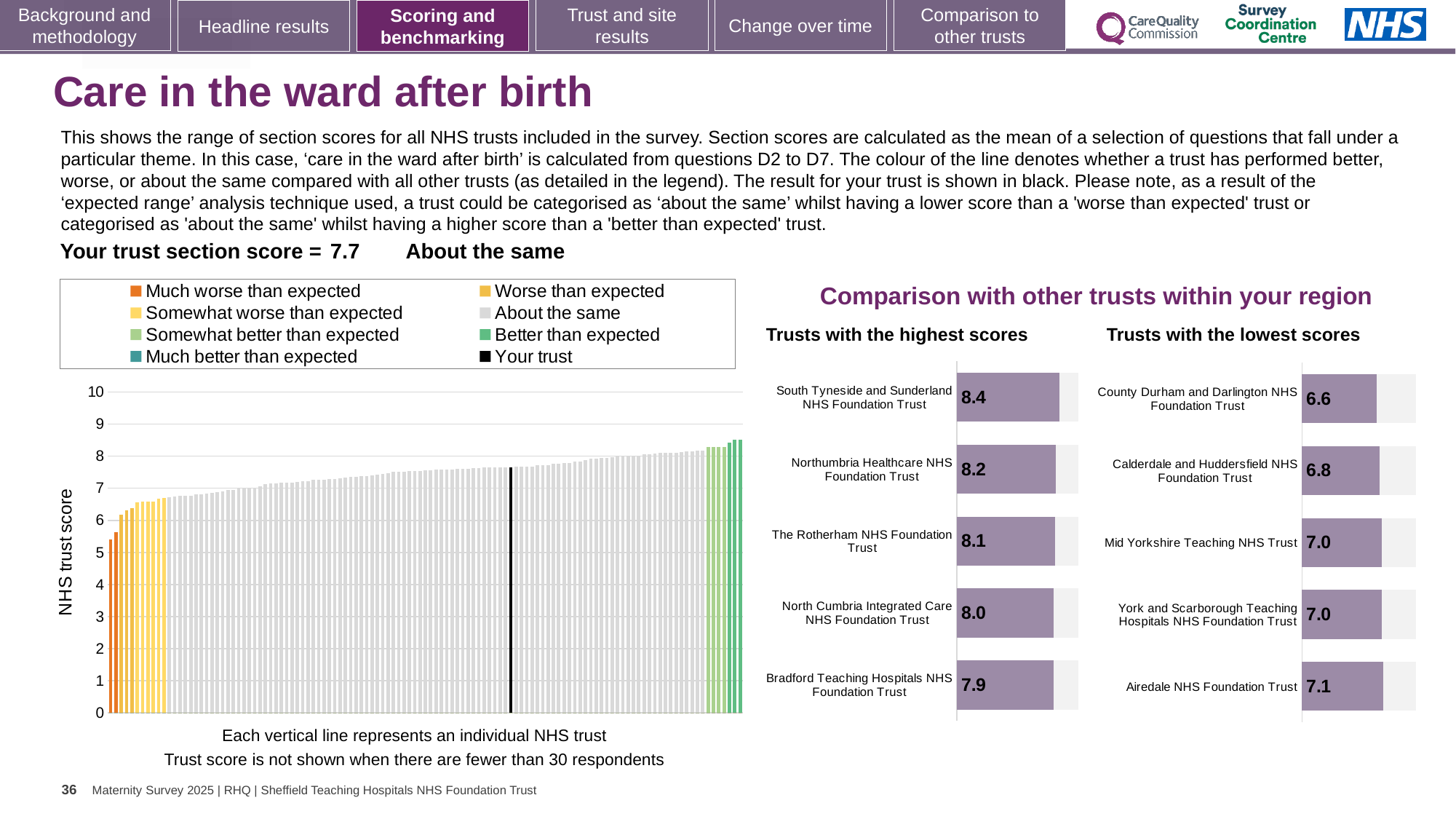
In the 'Trusts with the lowest scores' chart, which has the higher score: Calderdale and Huddersfield NHS Foundation Trust or Mid Yorkshire Teaching NHS Trust? Mid Yorkshire Teaching NHS Trust In the 'Trusts with the highest scores' chart, what is the difference between the scores of South Tyneside and Sunderland NHS Foundation Trust and Bradford Teaching Hospitals NHS Foundation Trust? 0.5 In the 'Trusts with the lowest scores' chart, which trust has the lowest score? County Durham and Darlington NHS Foundation Trust In the 'Trusts with the highest scores' chart, what is the score for South Tyneside and Sunderland NHS Foundation Trust? 8.4 In the 'Trusts with the highest scores' chart, which trust has the highest score? South Tyneside and Sunderland NHS Foundation Trust In the 'Trusts with the highest scores' chart, what is the score for Bradford Teaching Hospitals NHS Foundation Trust? 7.9 How many entries does the legend of the main 'NHS trust score' chart list? 8 In the main 'NHS trust score' chart, do the bar heights rise or fall from left to right? Rise In the 'Trusts with the lowest scores' chart, what is the score for Airedale NHS Foundation Trust? 7.1 What kind of chart is the main chart on the left with the 'NHS trust score' axis? Bar chart How many trusts are shown in the 'Trusts with the highest scores' chart? 5 In the 'Trusts with the lowest scores' chart, what is the score for County Durham and Darlington NHS Foundation Trust? 6.6